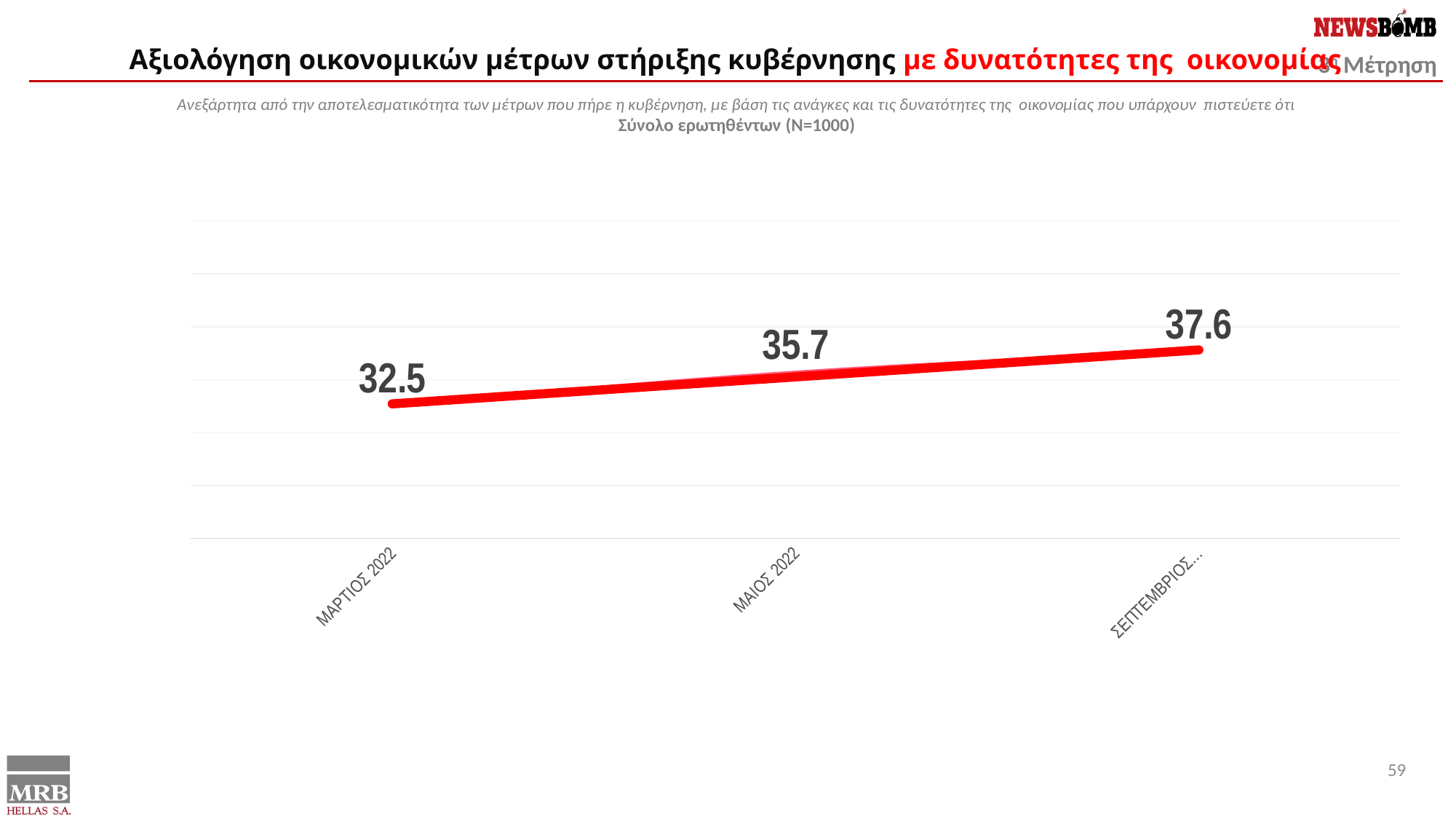
How many data points are plotted on the line? 3 What is the value for the last point, labelled ΣΕΠΤΕΜΒΡΙΟΣ…? 37.6 Which point has the lowest value? ΜΑΡΤΙΟΣ 2022 What kind of chart is shown on the slide? Line chart What is the difference between the first and last values on the line? 5.1 Which is larger, the value for ΜΑΙΟΣ 2022 or the value for ΜΑΡΤΙΟΣ 2022? ΜΑΙΟΣ 2022 Do the values rise or fall from ΜΑΡΤΙΟΣ 2022 to ΣΕΠΤΕΜΒΡΙΟΣ…? Rise What is the value for ΜΑΡΤΙΟΣ 2022? 32.5 What is the difference between the values for ΜΑΙΟΣ 2022 and ΜΑΡΤΙΟΣ 2022? 3.2 Which point has the highest value? ΣΕΠΤΕΜΒΡΙΟΣ… What is the value for ΜΑΙΟΣ 2022? 35.7 What is the difference between the values for ΣΕΠΤΕΜΒΡΙΟΣ… and ΜΑΙΟΣ 2022? 1.9